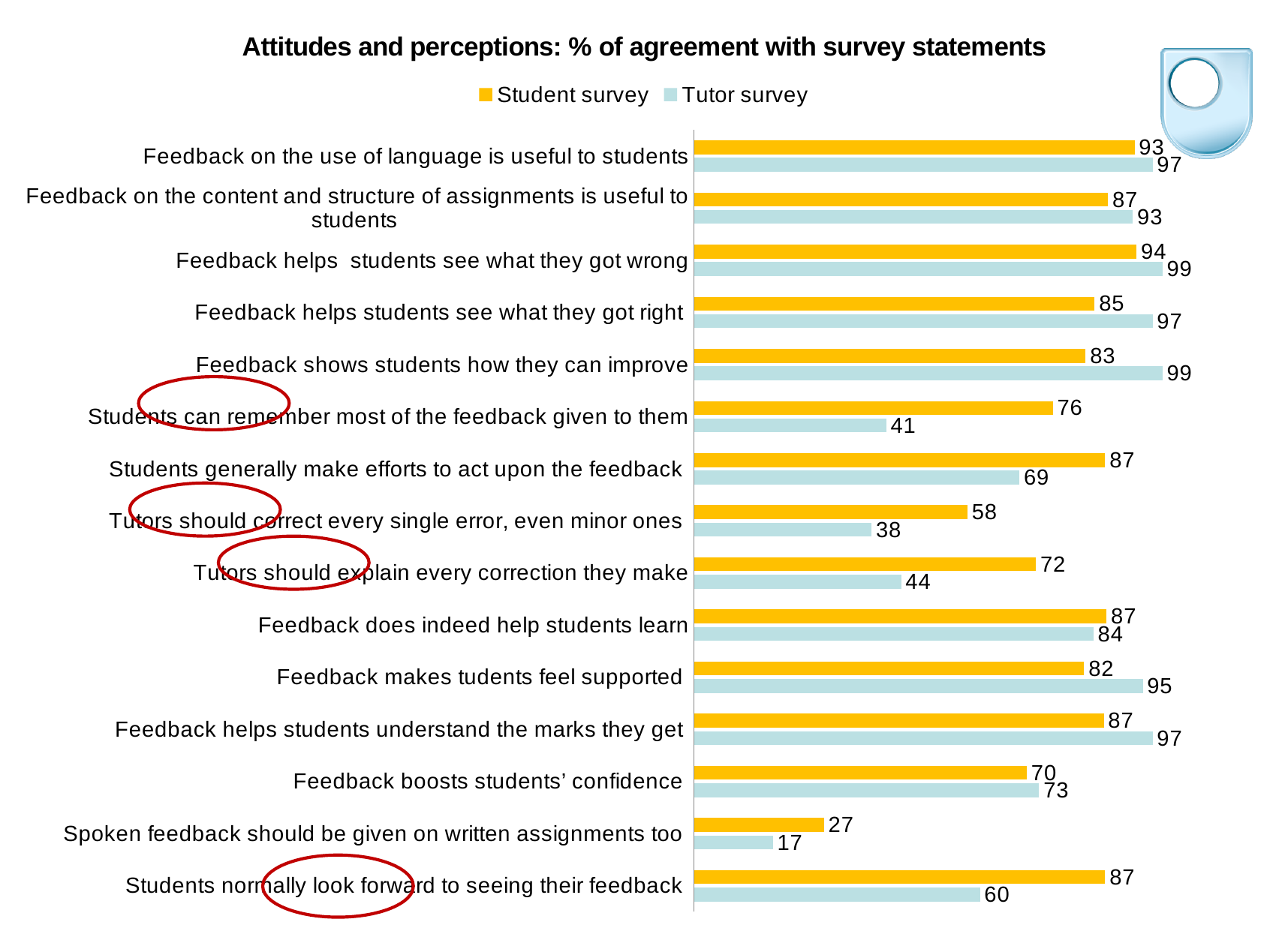
What is the Tutor survey value for "Tutors should correct every single error, even minor ones"? 38 What colour represents the Tutor survey series? Light blue For "Feedback boosts students' confidence", which is larger: the Student survey value or the Tutor survey value? Tutor survey What is the difference between the Student survey and Tutor survey values for "Tutors should explain every correction they make"? 28 For "Students generally make efforts to act upon the feedback", which is larger: the Student survey value or the Tutor survey value? Student survey What kind of chart is shown on the slide? Bar chart How many survey statements are shown on the chart? 15 Which statement has the highest Student survey value? Feedback helps students see what they got wrong What is the Tutor survey value for "Students normally look forward to seeing their feedback"? 60 Which statement has the lowest Tutor survey value? Spoken feedback should be given on written assignments too How many series does the legend list? 2 What is the Student survey value for "Students can remember most of the feedback given to them"? 76